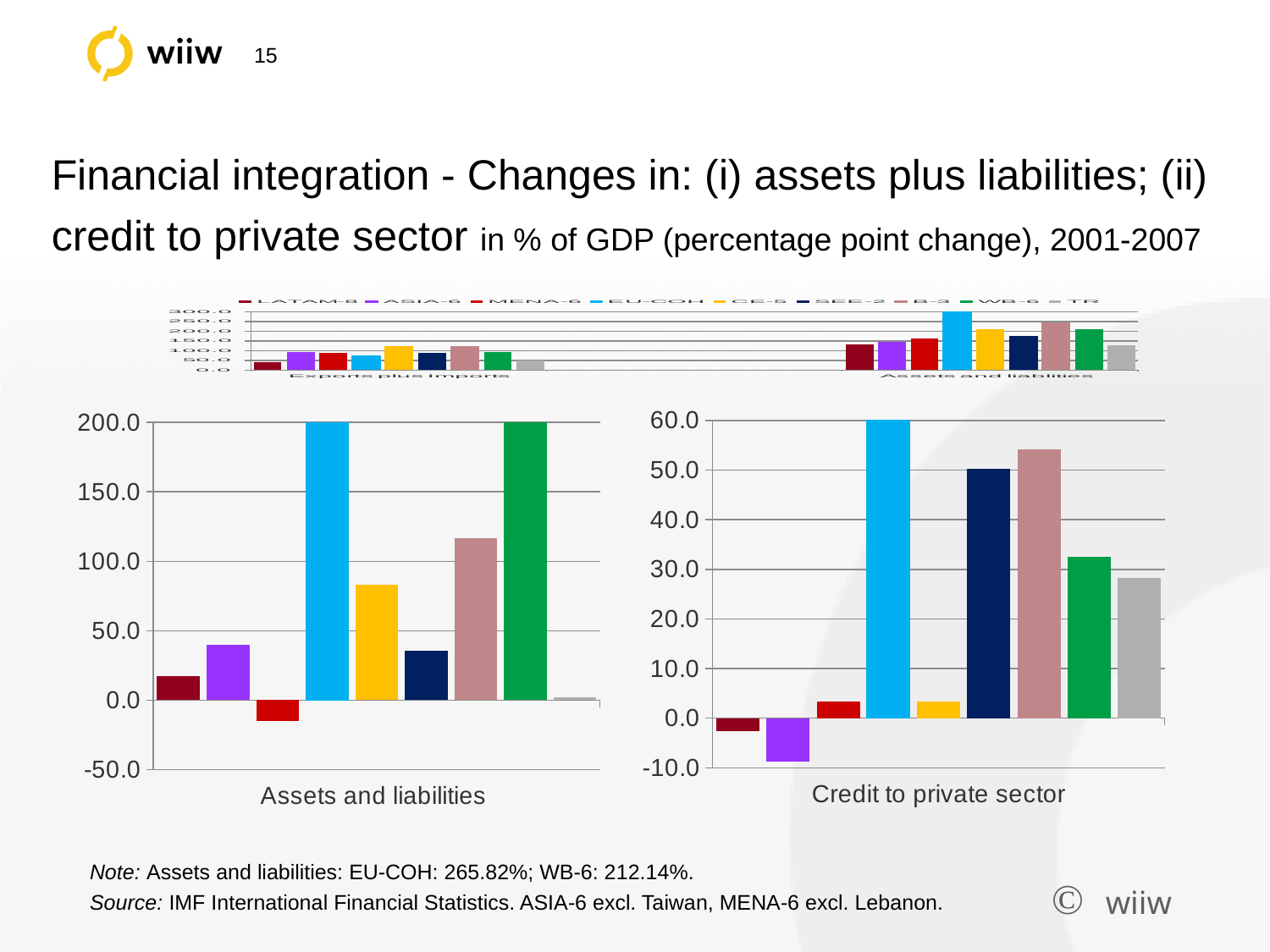
How many series does the legend at the top of the slide list? 9 According to the note, what is the assets and liabilities value for WB-6? 212.14% In the 'Assets and liabilities' chart, is the value for B-3 greater or less than 100.0? greater What kind of chart is the 'Assets and liabilities' chart? Bar chart Using the values in the note, how much larger is the assets and liabilities value for EU-COH than for WB-6? 53.68 percentage points How many bars are plotted in the 'Credit to private sector' chart? 9 In the 'Credit to private sector' chart, is the value for SEE-2 greater or less than 40.0? greater In the 'Assets and liabilities' chart, which series has the lowest value? MENA-6 In the 'Assets and liabilities' chart, which series has the highest value? EU-COH According to the note, what is the assets and liabilities value for EU-COH? 265.82% In the 'Credit to private sector' chart, which series has the lowest value? ASIA-6 In the 'Credit to private sector' chart, which series has the highest value? EU-COH